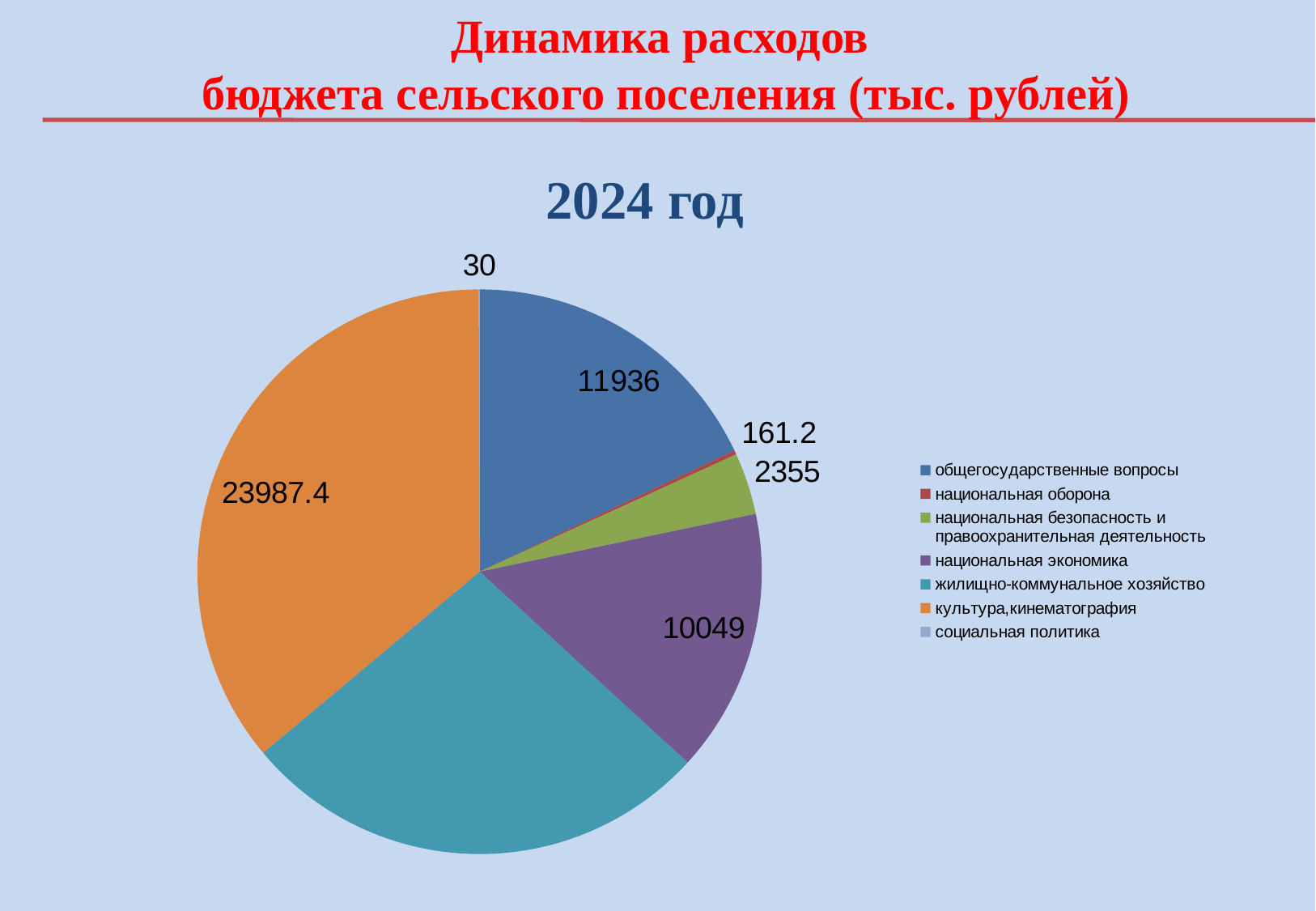
What type of chart is shown on the slide? pie chart What is the value for национальная оборона in the 2024 год pie chart? 161.2 What is the value for культура,кинематография in the 2024 год pie chart? 23987.4 What is the value for общегосударственные вопросы in the 2024 год pie chart? 11936 What is the value for национальная экономика in the 2024 год pie chart? 10049 What is the difference between the values for общегосударственные вопросы and национальная экономика in the 2024 год pie chart? 1887 What is the value for социальная политика in the 2024 год pie chart? 30 What colour is the slice for жилищно-коммунальное хозяйство in the 2024 год pie chart? teal How many categories does the legend of the 2024 год pie chart list? 7 Which category has the largest slice in the 2024 год pie chart? культура,кинематография Which category has the smallest slice in the 2024 год pie chart? социальная политика Which is larger in the 2024 год pie chart: общегосударственные вопросы or национальная экономика? общегосударственные вопросы